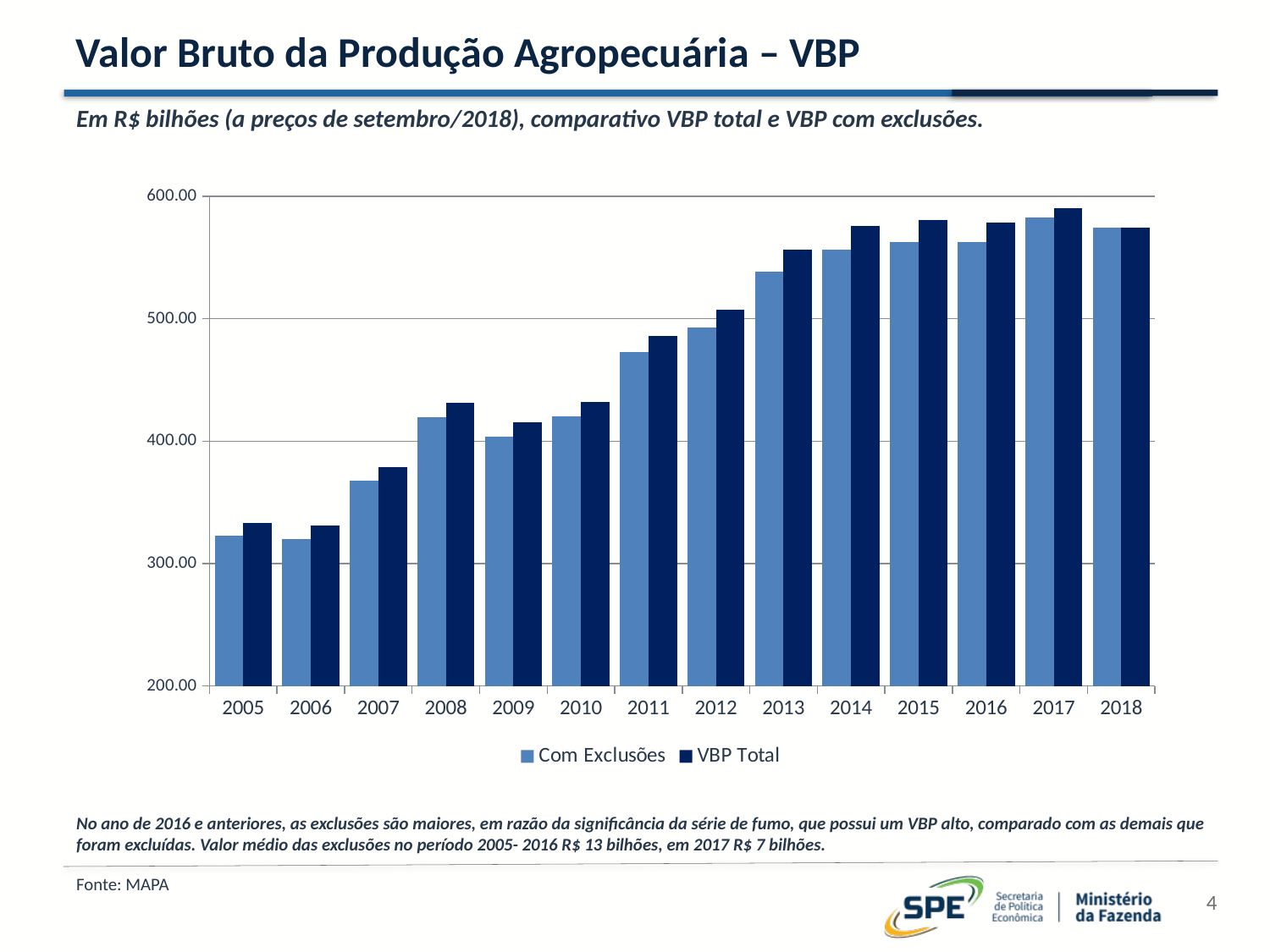
How many series does the legend list? 2 Which year has the highest VBP Total value? 2017 Which year has the highest Com Exclusões value? 2017 Is the VBP Total value for 2011 greater or less than 500.00? less In 2013, which is larger: VBP Total or Com Exclusões? VBP Total Is the Com Exclusões value for 2007 greater or less than 400.00? less What are the two series named in the legend? Com Exclusões and VBP Total Is the VBP Total value for 2005 greater or less than 300.00? greater What kind of chart is shown on the slide? bar chart How many years are shown on the x axis? 14 Do the VBP Total values generally rise or fall from 2005 to 2017? rise